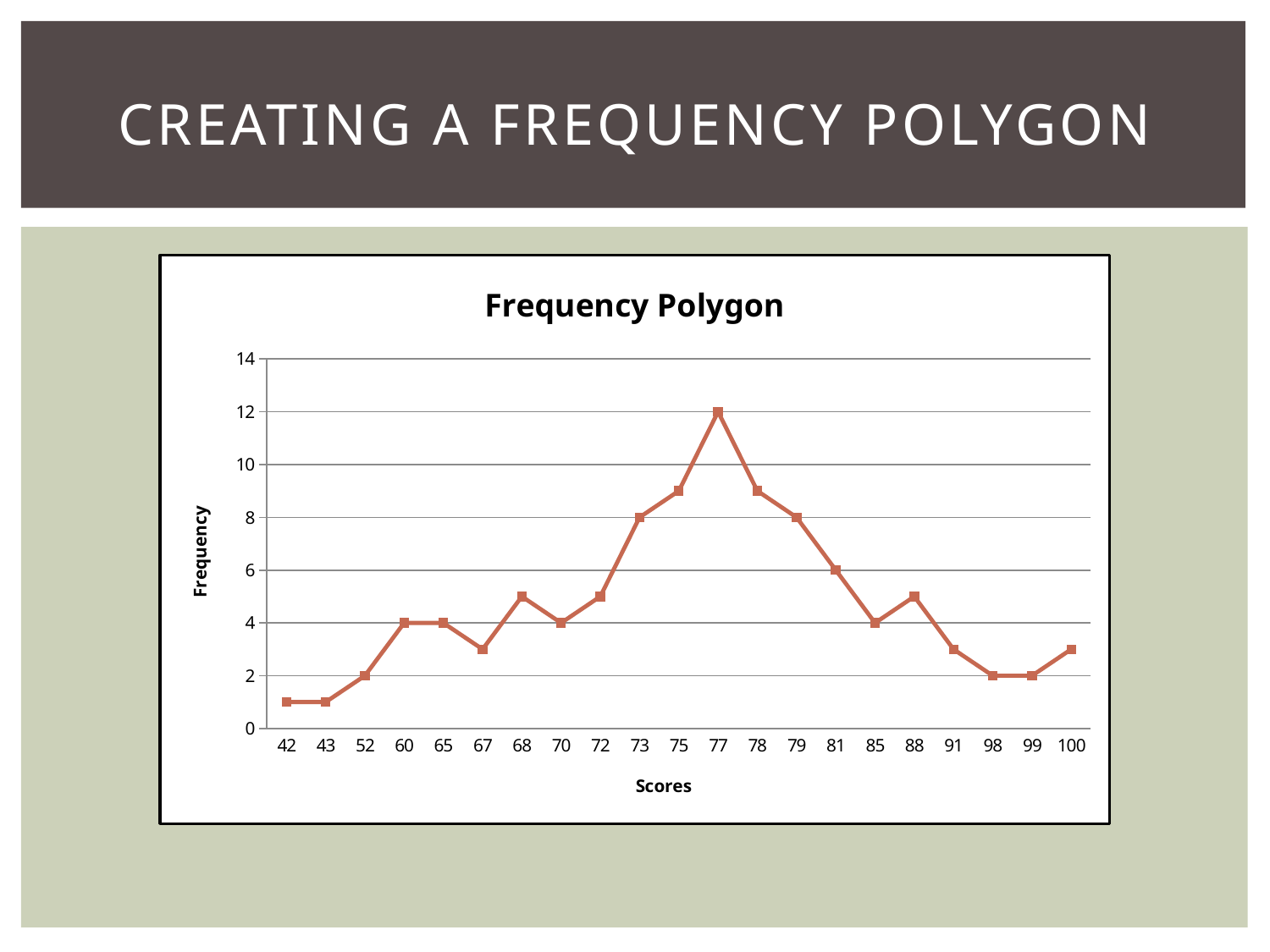
Is the frequency for score 91 greater or less than 4? less Which score has the highest frequency? 77 What is the difference between the frequency for score 77 and the frequency for score 73? 4 Which has a higher frequency, score 73 or score 81? 73 What is the title of the chart? Frequency Polygon What is the frequency for the score 81? 6 What is the frequency for the score 98? 2 What is the label of the vertical axis? Frequency How many score categories are plotted on the x axis? 21 What is the frequency for the score 77? 12 What is the frequency for the score 73? 8 What type of chart is shown on the slide? line chart